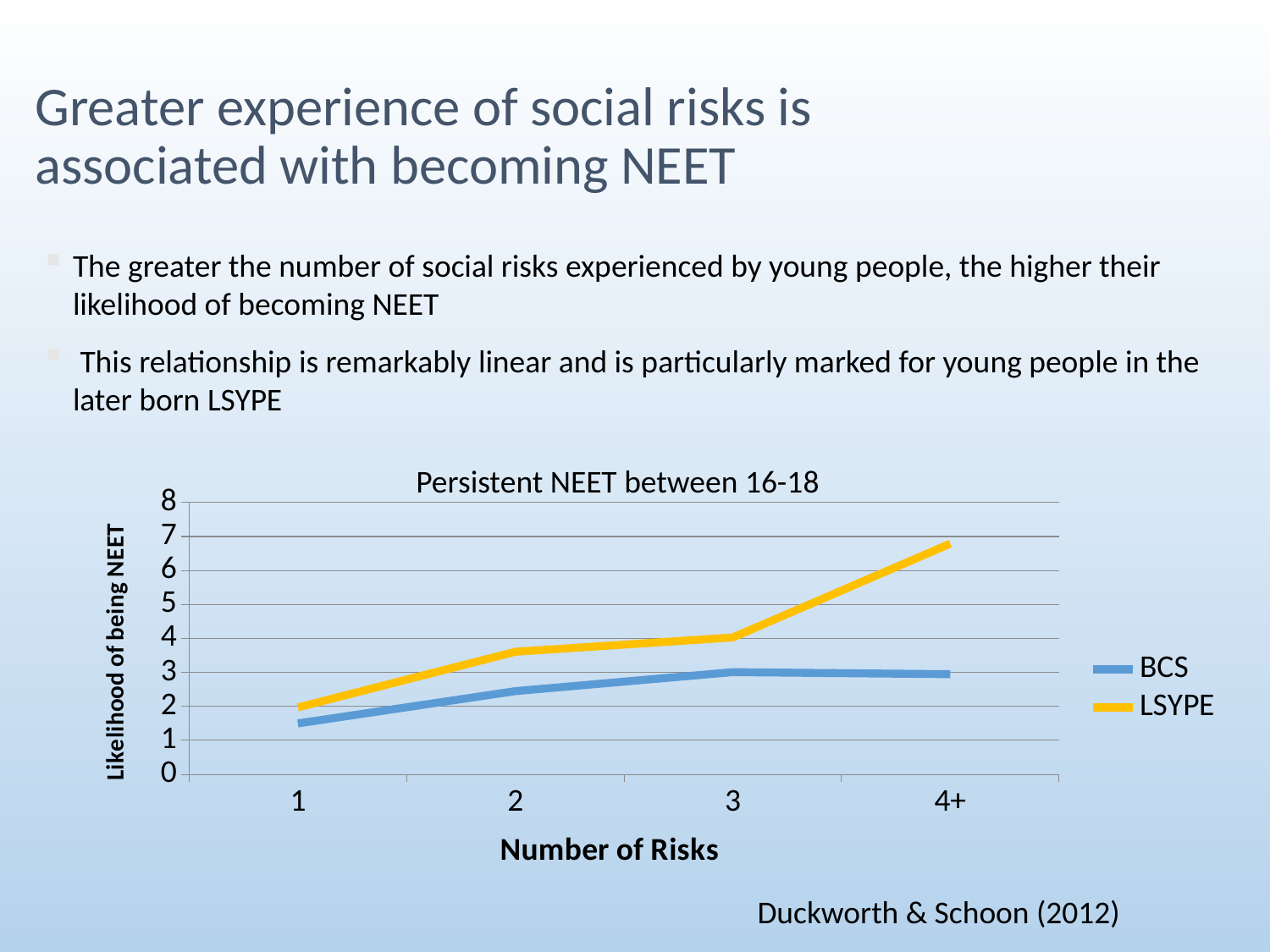
Is the BCS value at 4+ risks greater or less than 4? less What kind of chart is shown on the slide? line chart Is the LSYPE value at 4+ risks greater or less than 6? greater Is the BCS value at 1 risk greater or less than 2? less Does the LSYPE line rise or fall as the number of risks increases from 1 to 4+? rise At 4+ risks, which series has the larger value, BCS or LSYPE? LSYPE How many categories are shown on the x axis (Number of Risks)? 4 How many series does the legend list? 2 What is the title of the chart? Persistent NEET between 16-18 At which number of risks is the BCS value lowest? 1 At which number of risks is the LSYPE value lowest? 1 At which number of risks is the LSYPE value highest? 4+